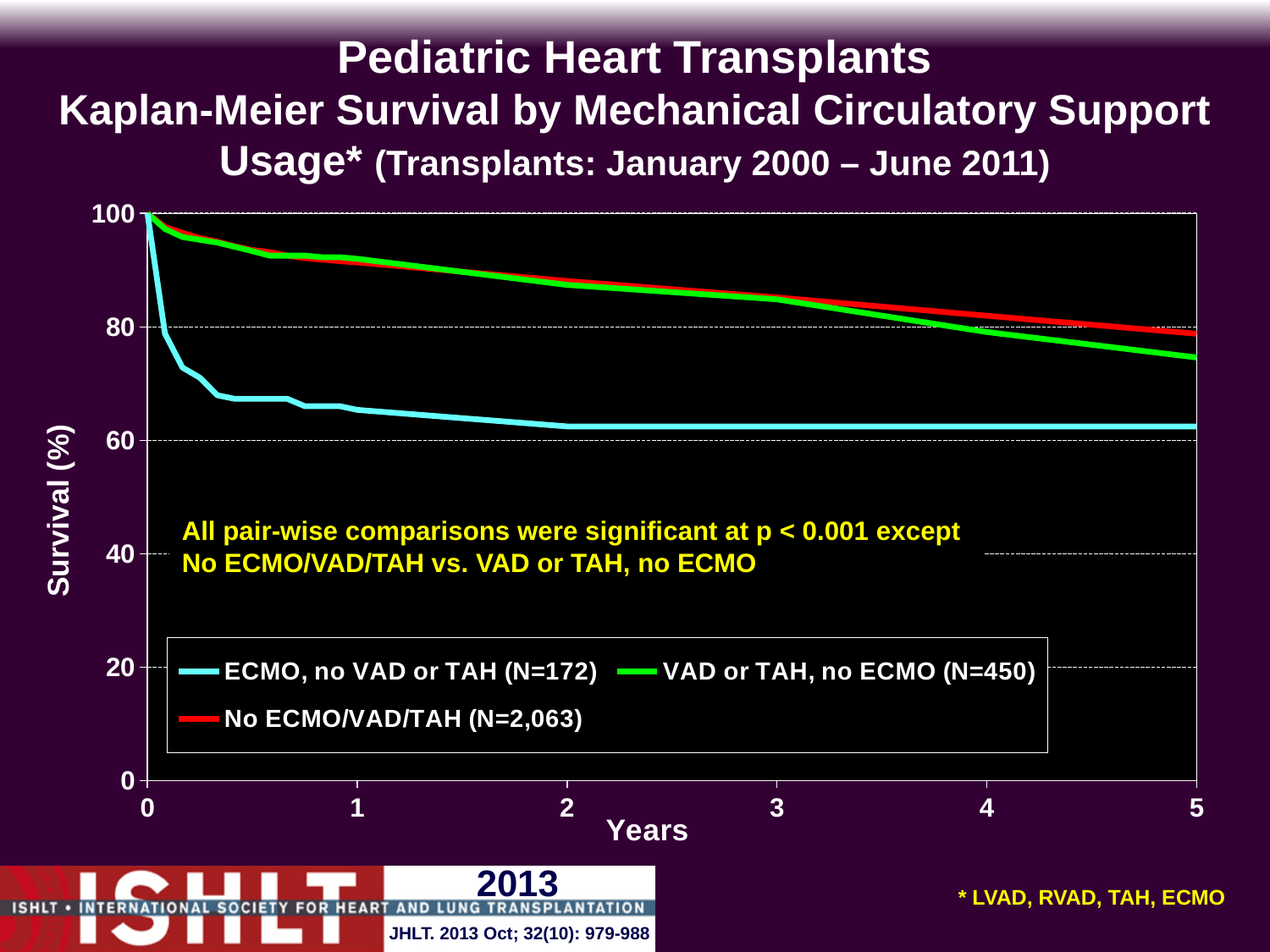
What is the N shown in the legend for the ECMO, no VAD or TAH series? N=172 At 5 years, which has higher survival: ECMO, no VAD or TAH, or VAD or TAH, no ECMO? VAD or TAH, no ECMO Which series has the lowest survival at 5 years? ECMO, no VAD or TAH (N=172) Is the survival for No ECMO/VAD/TAH at 1 year greater or less than 80? greater Is the survival for ECMO, no VAD or TAH at 5 years greater or less than 80? less What is the label of the x axis? Years What kind of chart is shown on the slide? Line chart Which series has the highest survival at 5 years? No ECMO/VAD/TAH (N=2,063) Do the survival curves rise or fall as years increase? Fall How many series does the legend list? 3 Is the survival for VAD or TAH, no ECMO at 5 years greater or less than 80? less